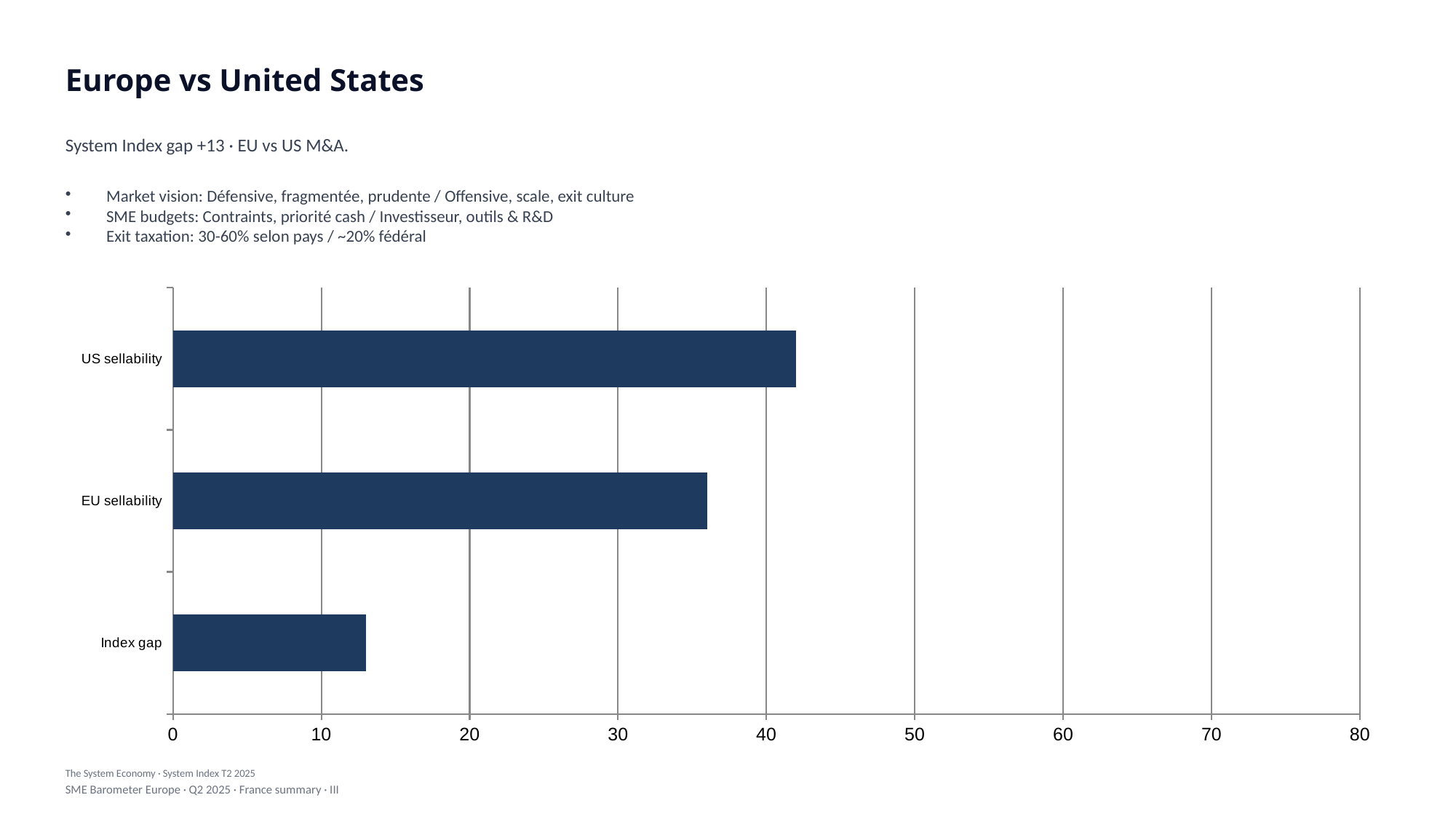
Is the value for EU sellability greater or less than 40? less Which category has the highest value in the chart? US sellability Is the value for EU sellability greater or less than 30? greater Which category has the lowest value in the chart? Index gap What is the maximum value shown on the horizontal axis of the chart? 80 Is the value for US sellability greater or less than 40? greater Which is larger, US sellability or EU sellability? US sellability How many categories does the chart show? 3 What kind of chart is shown on the slide? bar chart Which is larger, EU sellability or Index gap? EU sellability